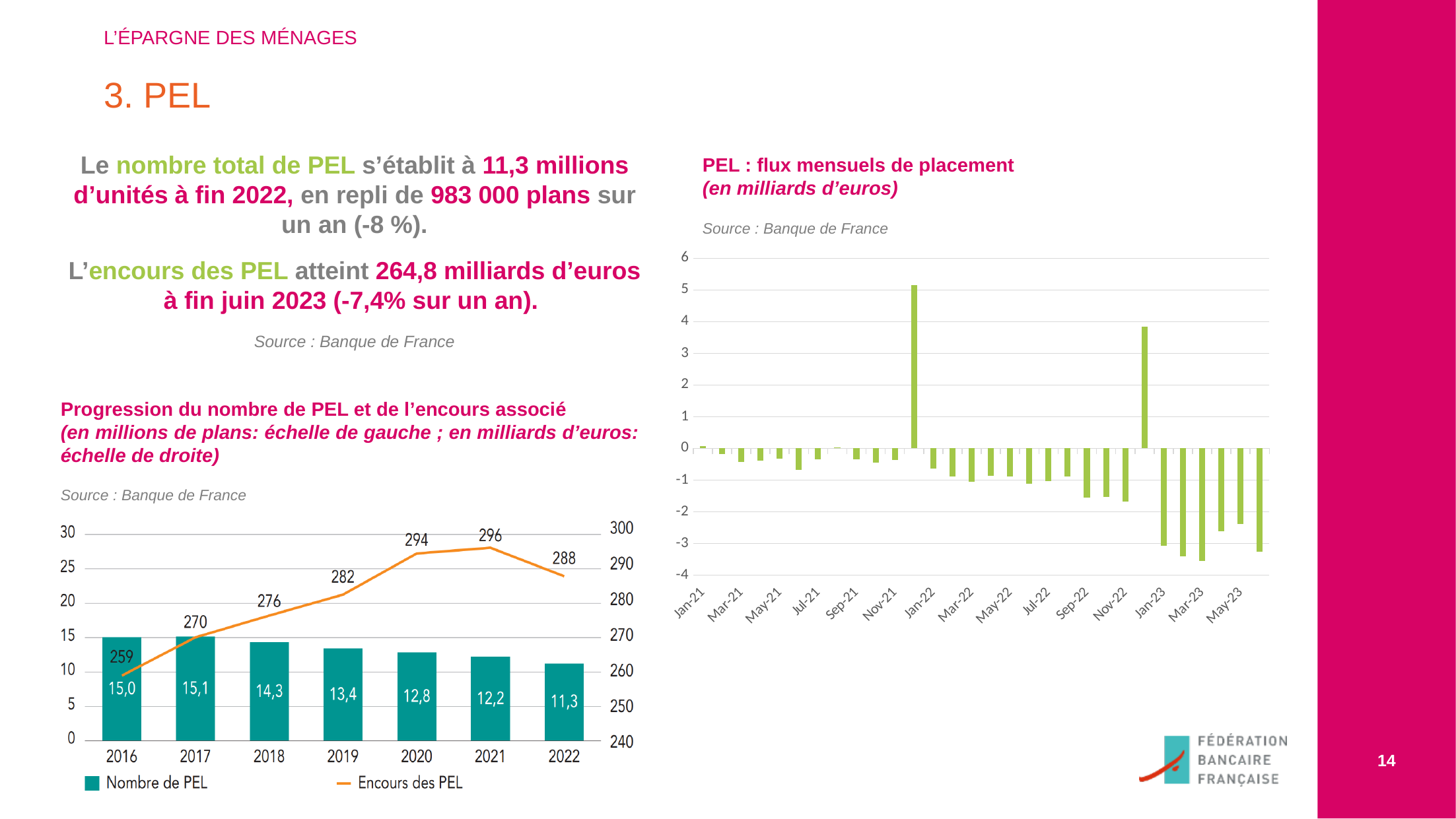
In the chart 'Progression du nombre de PEL et de l'encours associé', how many years are shown on the x axis? 7 In the chart 'Progression du nombre de PEL et de l'encours associé', what is the difference between the Nombre de PEL in 2016 and in 2022? 3,7 In the chart 'Progression du nombre de PEL et de l'encours associé', does the Nombre de PEL rise or fall from 2017 to 2022? fall In the chart 'Progression du nombre de PEL et de l'encours associé', which year has the lowest Nombre de PEL? 2022 In the chart 'Progression du nombre de PEL et de l'encours associé', what is the Nombre de PEL for 2022? 11,3 In the chart 'Progression du nombre de PEL et de l'encours associé', what is the difference between the Encours des PEL in 2021 and in 2016? 37 In the chart 'Progression du nombre de PEL et de l'encours associé', how many series does the legend list? 2 In the chart 'Progression du nombre de PEL et de l'encours associé', what is the Encours des PEL for 2019? 282 In the chart 'Progression du nombre de PEL et de l'encours associé', which year has the highest Encours des PEL? 2021 In the chart 'Progression du nombre de PEL et de l'encours associé', is the Nombre de PEL higher in 2018 or in 2020? 2018 What kind of chart is 'PEL : flux mensuels de placement'? bar chart In the chart 'PEL : flux mensuels de placement', is the value for Jan-22 greater or less than 4? less